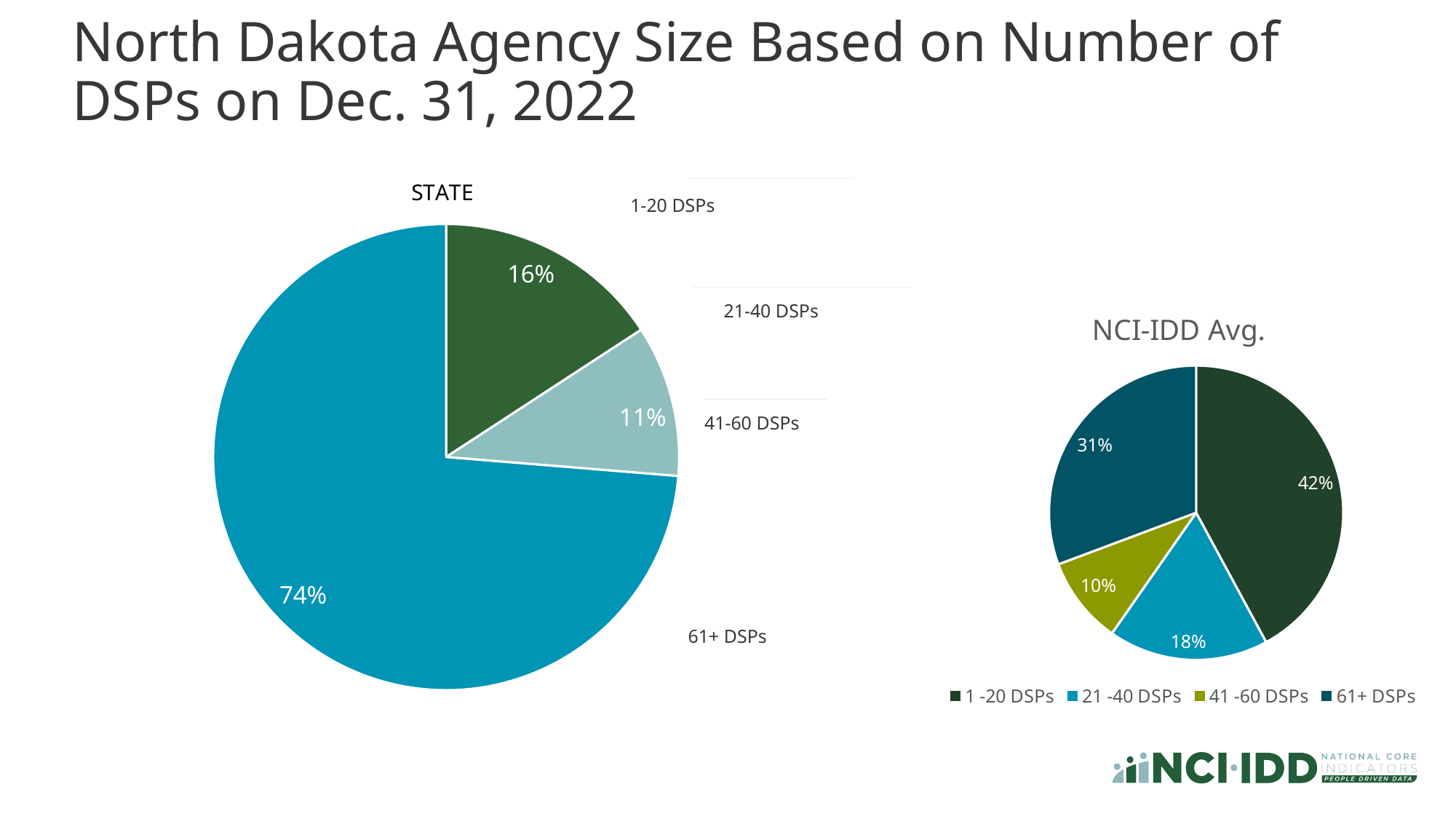
What is the difference between the 61+ DSPs share in the STATE chart and the 61+ DSPs share in the NCI-IDD Avg. chart? 43 percentage points In the NCI-IDD Avg. pie chart, which category has the largest share? 1-20 DSPs In the NCI-IDD Avg. pie chart, which category has the smallest share? 41-60 DSPs In the NCI-IDD Avg. pie chart, what percentage of agencies have 61+ DSPs? 31% In the STATE pie chart, which category has the largest share? 61+ DSPs How many categories does the legend below the NCI-IDD Avg. chart list? 4 In the NCI-IDD Avg. pie chart, what percentage of agencies have 1-20 DSPs? 42% In the STATE pie chart, what percentage of agencies have 61+ DSPs? 74% In the STATE pie chart, what percentage of agencies have 1-20 DSPs? 16% Which is larger: the 1-20 DSPs share in the STATE chart or in the NCI-IDD Avg. chart? NCI-IDD Avg. In the NCI-IDD Avg. pie chart, what percentage of agencies have 41-60 DSPs? 10% What type of chart is used for the STATE and NCI-IDD Avg. data? Pie chart